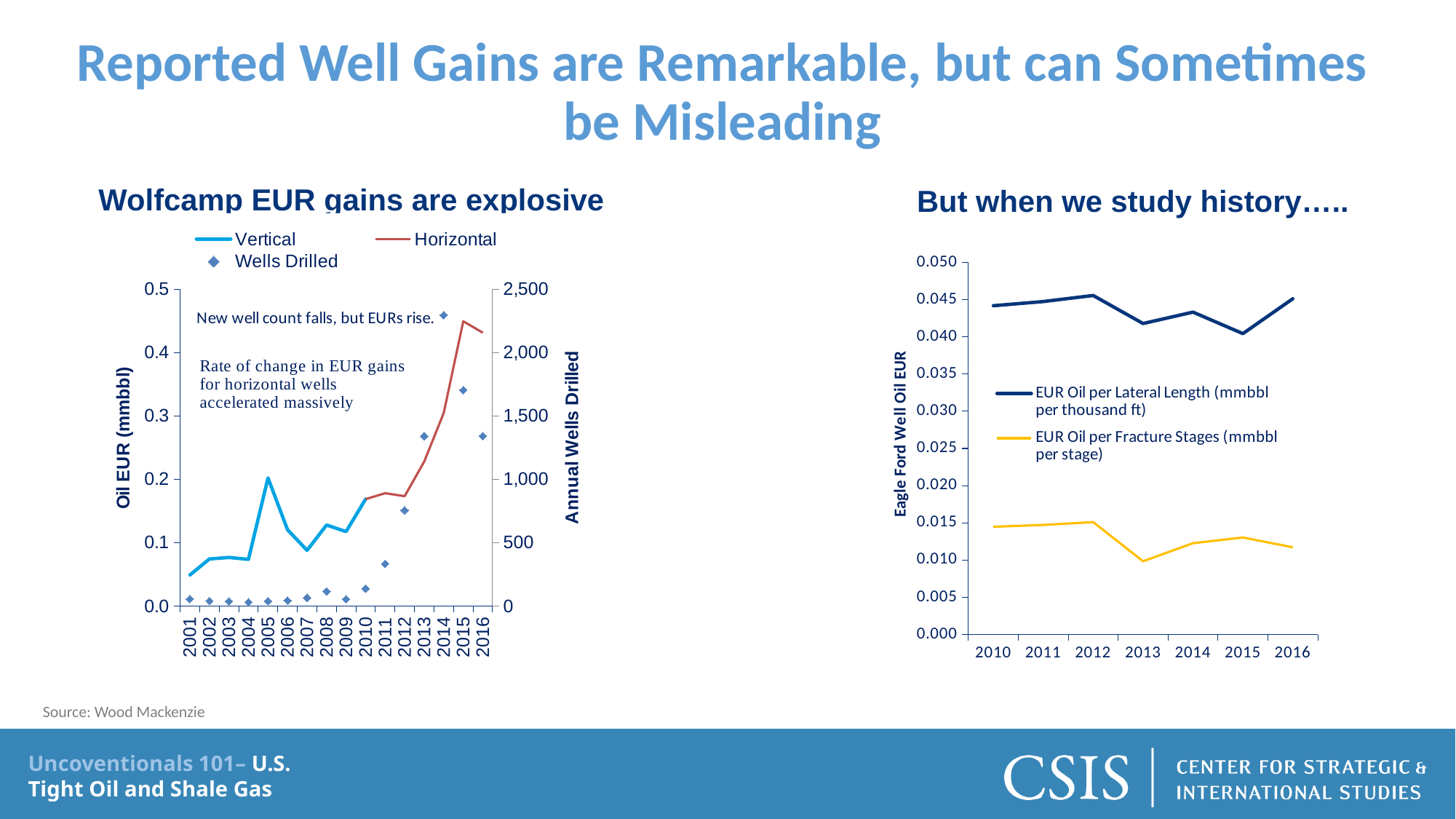
In the chart titled "Wolfcamp EUR gains are explosive", what is the label of the right-hand vertical axis? Annual Wells Drilled In the chart titled "Wolfcamp EUR gains are explosive", is the Wells Drilled value for 2014 greater or less than 2,000? greater In the chart titled "But when we study history…..", is the EUR Oil per Lateral Length value for 2010 greater or less than 0.040? greater In the chart titled "But when we study history…..", how many series does the legend list? 2 In the chart titled "But when we study history…..", in which year is EUR Oil per Fracture Stages lowest? 2013 In the chart titled "Wolfcamp EUR gains are explosive", in which year is the Wells Drilled value highest? 2014 In the chart titled "Wolfcamp EUR gains are explosive", how many years are shown on the x axis? 16 In the chart titled "Wolfcamp EUR gains are explosive", what kind of chart is it? line chart In the chart titled "Wolfcamp EUR gains are explosive", how many series does the legend list? 3 In the chart titled "Wolfcamp EUR gains are explosive", is the Vertical value for 2005 greater or less than 0.1? greater In the chart titled "But when we study history…..", which series has the larger value in 2012: EUR Oil per Lateral Length or EUR Oil per Fracture Stages? EUR Oil per Lateral Length In the chart titled "But when we study history…..", how many years are shown on the x axis? 7